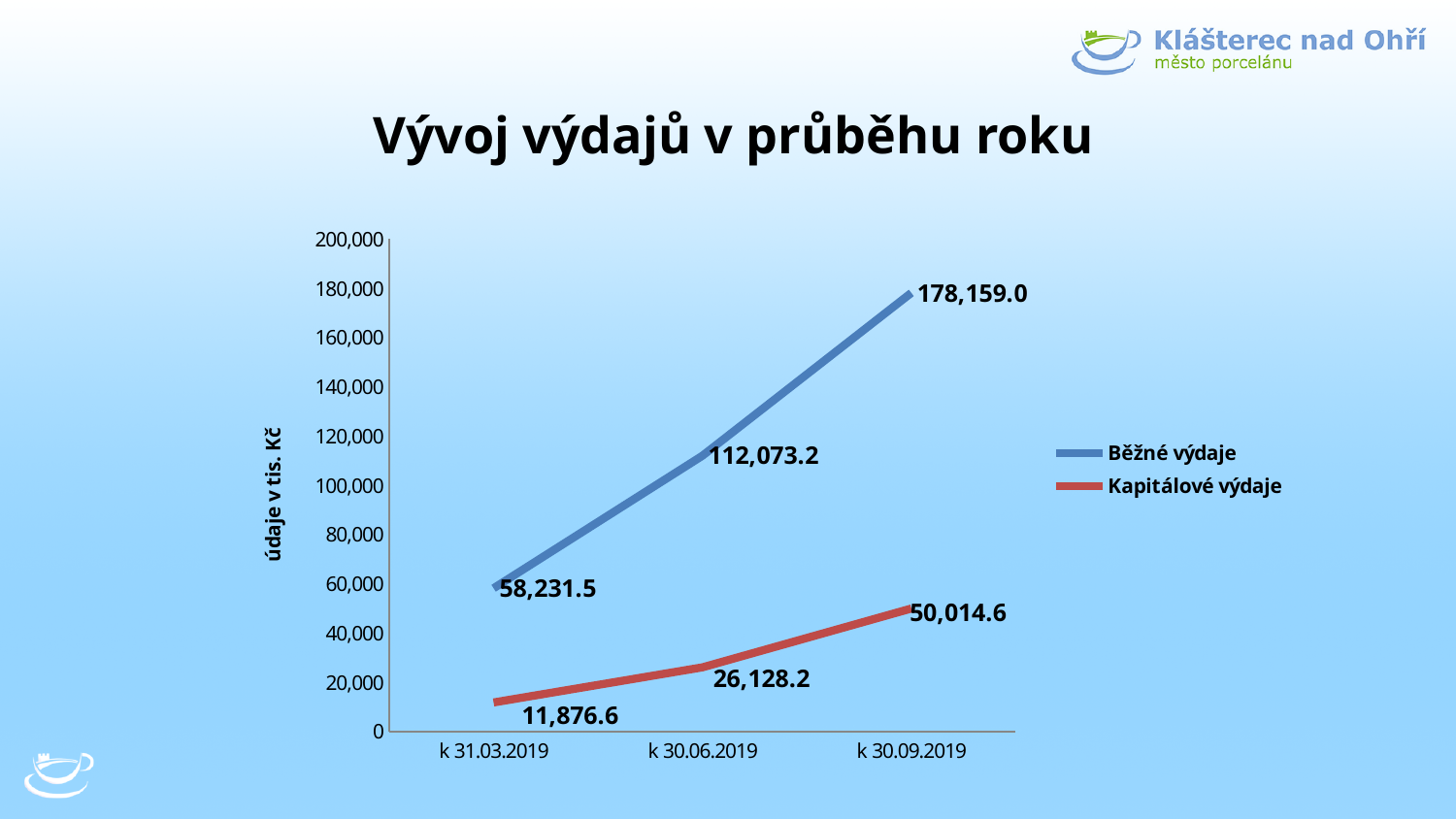
What is the value of Běžné výdaje at k 30.06.2019? 112,073.2 What is the value of Kapitálové výdaje at k 30.09.2019? 50,014.6 Do the values of Kapitálové výdaje rise or fall along the x axis? rise What is the difference between Běžné výdaje at k 30.09.2019 and at k 30.06.2019? 66,085.8 What is the value of Běžné výdaje at k 30.09.2019? 178,159.0 Which is larger at k 30.06.2019, Běžné výdaje or Kapitálové výdaje? Běžné výdaje At which date is Běžné výdaje highest? k 30.09.2019 At which date is Kapitálové výdaje lowest? k 31.03.2019 How many series does the legend list? 2 What type of chart is shown on the slide? line chart How many points along the x axis does each series have? 3 What is the value of Kapitálové výdaje at k 31.03.2019? 11,876.6